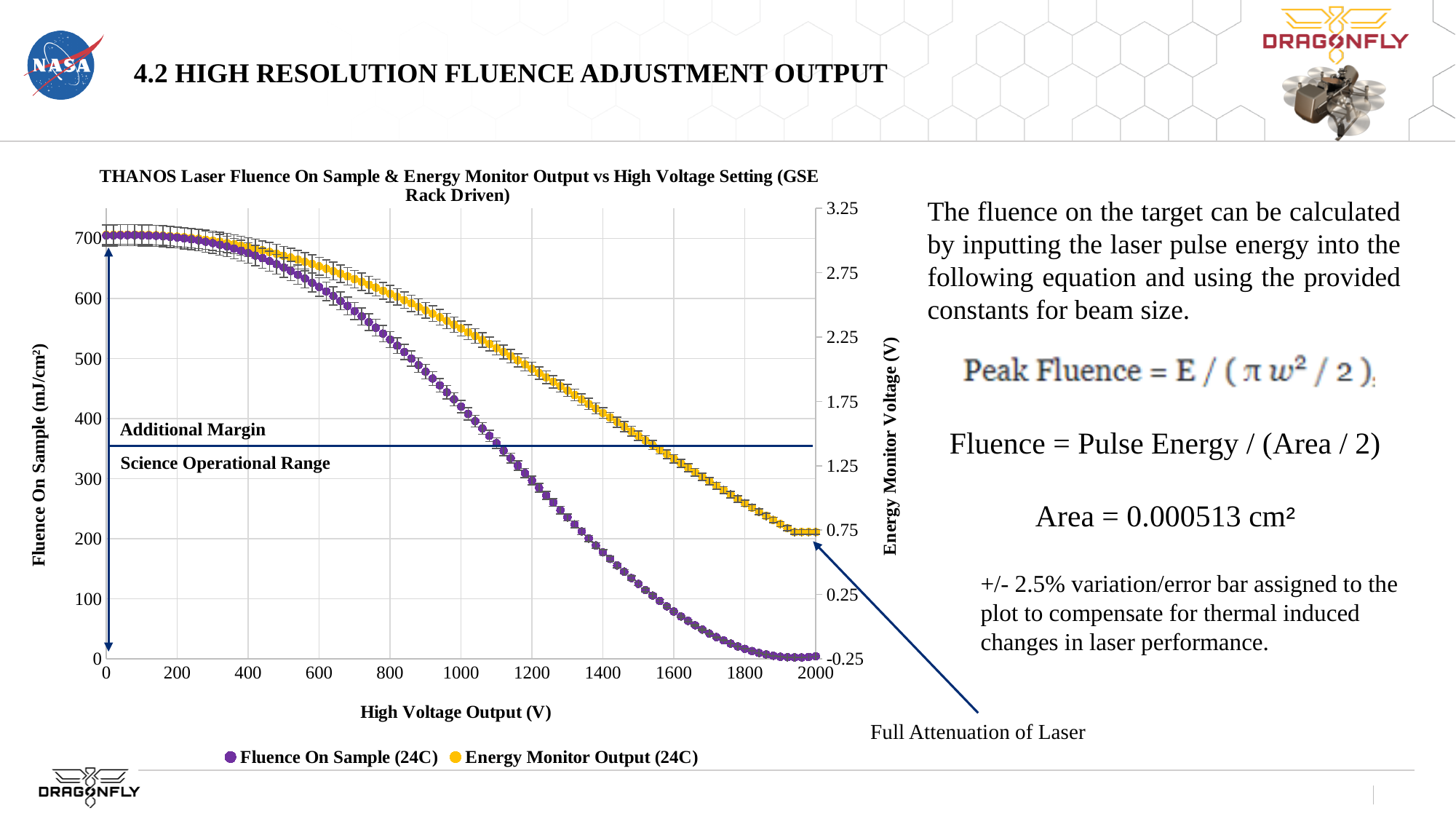
Is the Energy Monitor Output (24C) value at 1000 V greater or less than 2.75 V? less Does the Fluence On Sample (24C) series rise or fall as High Voltage Output increases? fall What is the title of the chart? THANOS Laser Fluence On Sample & Energy Monitor Output vs High Voltage Setting (GSE Rack Driven) Is the Fluence On Sample (24C) value at 800 V greater or less than 500 mJ/cm²? greater Does the Energy Monitor Output (24C) series rise or fall as High Voltage Output increases? fall Is the Energy Monitor Output (24C) value at 400 V greater or less than 2.25 V? greater What are the two series named in the chart legend? Fluence On Sample (24C) and Energy Monitor Output (24C) What kind of chart is shown on the slide? scatter chart How many series does the chart legend list? 2